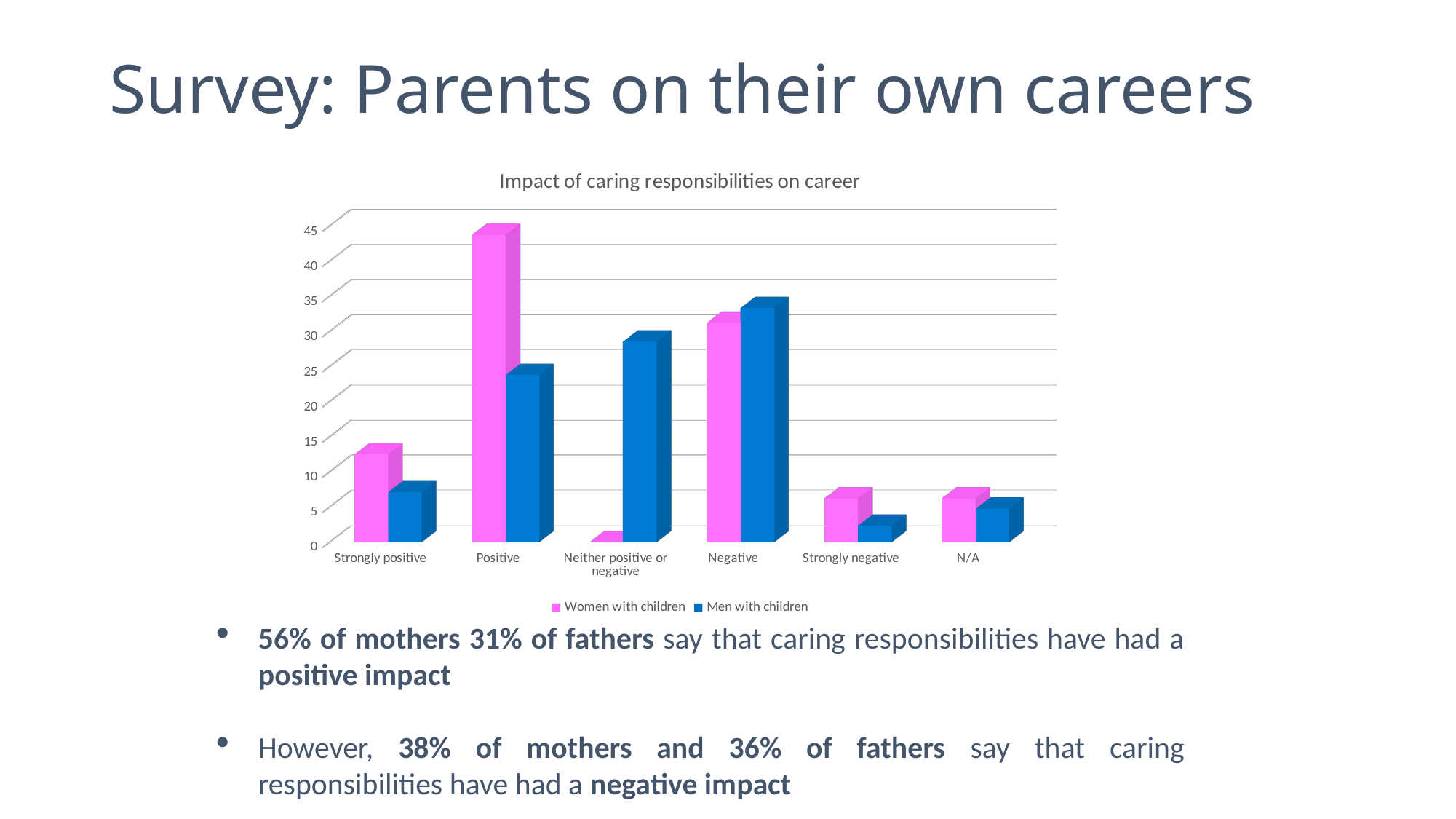
Is the value for Men with children in the Neither positive or negative category greater or less than 25? greater How many series does the legend list? 2 Which colour represents Women with children in the chart? pink Which category has the highest value for Women with children? Positive In the Neither positive or negative category, which series has the larger value? Men with children Which category has the lowest value for Men with children? Strongly negative Is the value for Men with children in the Positive category greater or less than 30? less What is the title of the chart? Impact of caring responsibilities on career How many categories are shown on the x axis? 6 Is the value for Women with children in the Positive category greater or less than 40? greater Which category has the lowest value for Women with children? Neither positive or negative What kind of chart is shown on the slide? bar chart